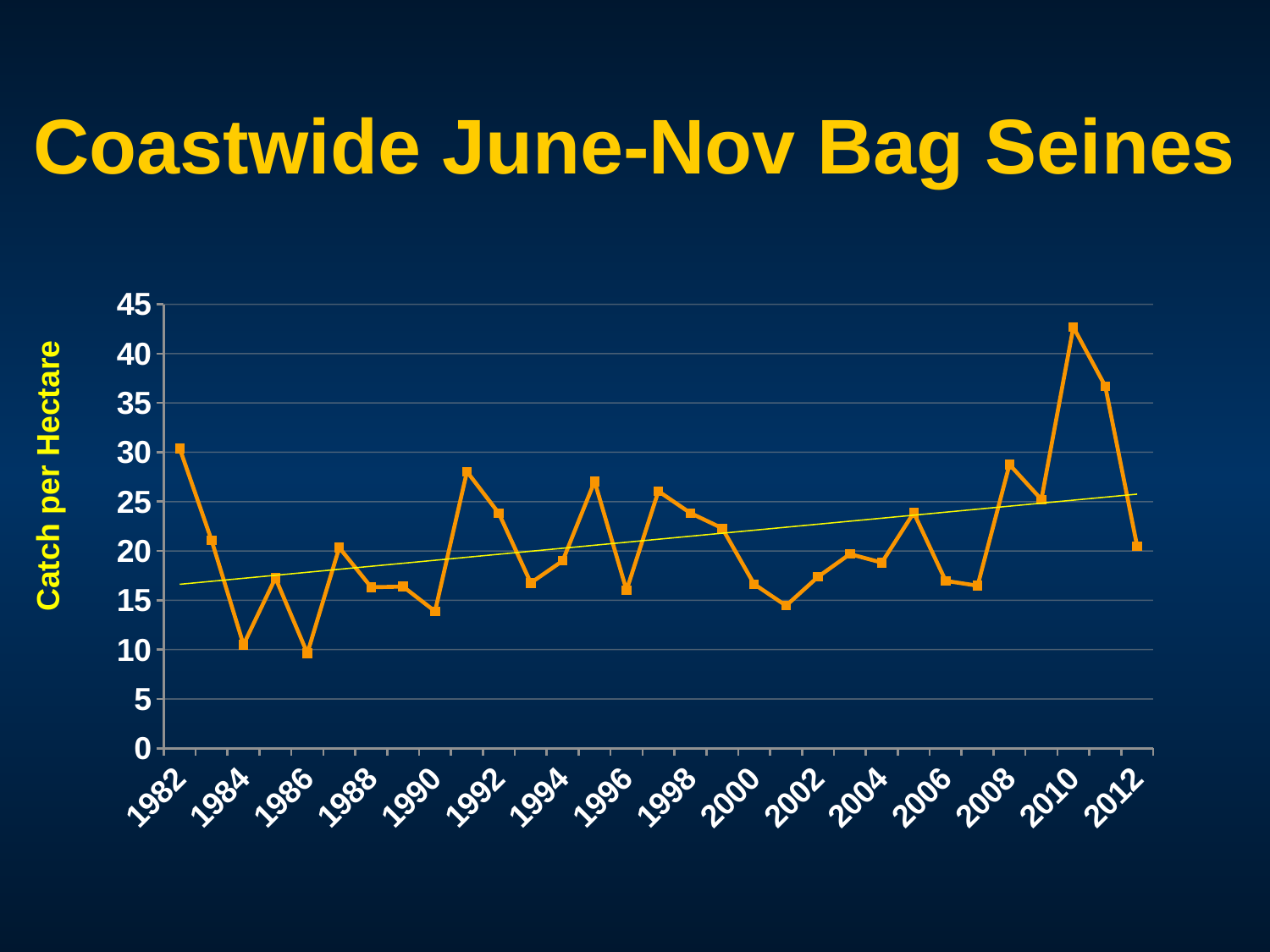
Is the value for 1986 greater or less than 15? less Which year has the larger catch per hectare, 2010 or 2012? 2010 Does the straight trend line rise or fall from 1982 to 2012? rise Which year has the larger catch per hectare, 1990 or 1991? 1991 Is the value for 2011 greater or less than 35? greater What is the label on the vertical axis? Catch per Hectare Is the value for 2008 greater or less than 25? greater What kind of chart is shown on the slide? line chart Which year has the highest catch per hectare? 2010 What is the title of the chart? Coastwide June-Nov Bag Seines